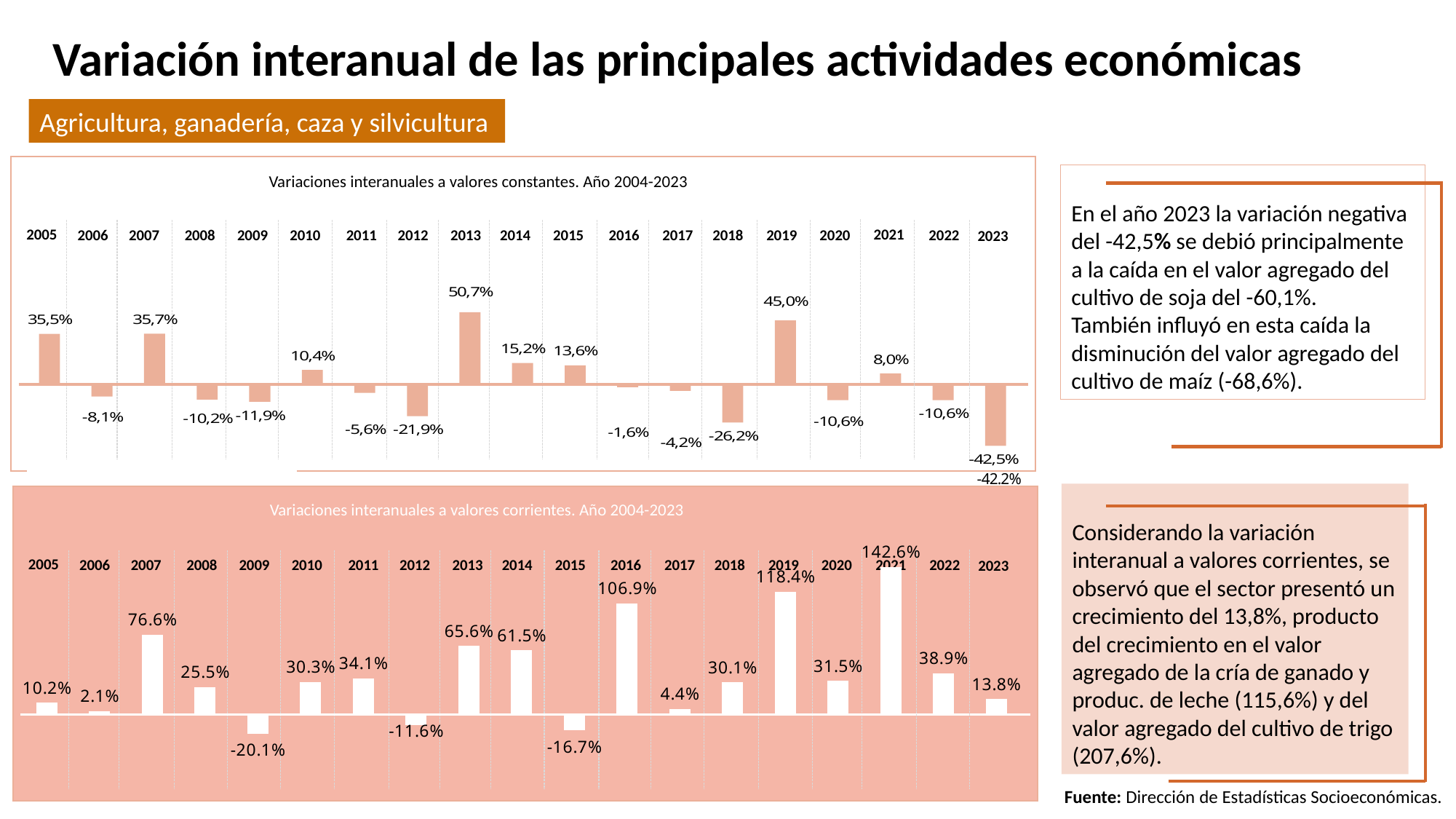
In the chart 'Variaciones interanuales a valores corrientes. Año 2004-2023', what is the difference between the values for 2007 and 2008? 51.1 percentage points In the chart 'Variaciones interanuales a valores constantes. Año 2004-2023', what is the value for 2023? -42,5% In the chart 'Variaciones interanuales a valores constantes. Año 2004-2023', what is the difference between the values for 2019 and 2014? 29,8 percentage points In the chart 'Variaciones interanuales a valores corrientes. Año 2004-2023', which year has the highest value? 2021 In the chart 'Variaciones interanuales a valores constantes. Año 2004-2023', how many years are plotted? 19 In the chart 'Variaciones interanuales a valores constantes. Año 2004-2023', what is the value for 2013? 50,7% In the chart 'Variaciones interanuales a valores corrientes. Año 2004-2023', which is larger, the value for 2013 or the value for 2016? 2016 In the chart 'Variaciones interanuales a valores constantes. Año 2004-2023', which year has the lowest value? 2023 In the chart 'Variaciones interanuales a valores corrientes. Año 2004-2023', what is the value for 2021? 142.6% In the chart 'Variaciones interanuales a valores corrientes. Año 2004-2023', what is the value for 2009? -20.1% In the chart 'Variaciones interanuales a valores constantes. Año 2004-2023', which year has the highest value? 2013 What type of chart is 'Variaciones interanuales a valores corrientes. Año 2004-2023'? Bar chart